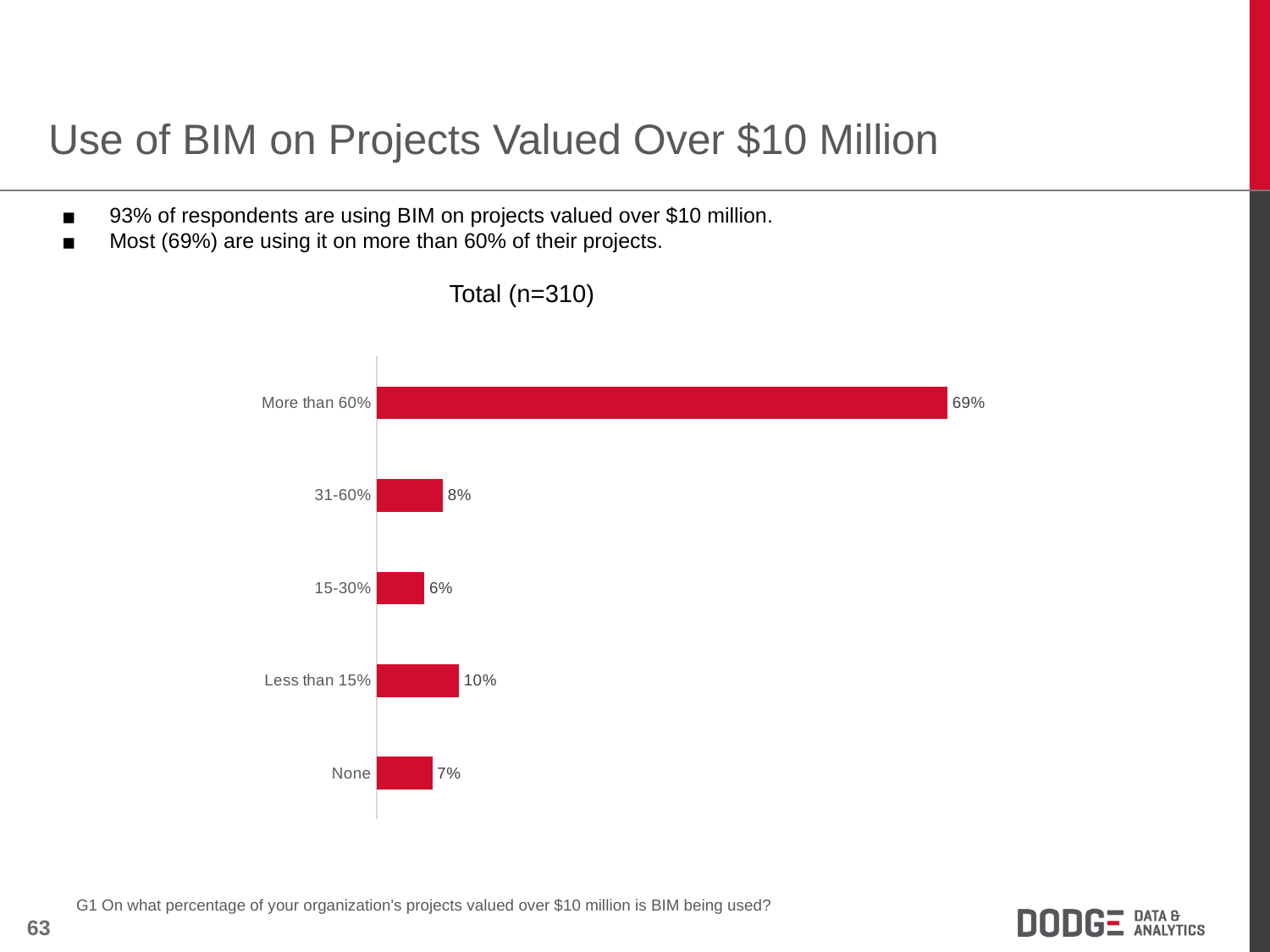
What is the title shown above the chart? Total (n=310) What kind of chart is shown on the slide? Bar chart Which is larger, the value for 'Less than 15%' or the value for 'None'? Less than 15% What percentage of respondents use BIM on more than 60% of their projects valued over $10 million? 69% Which category has the lowest value? 15-30% What is the value for the 'Less than 15%' category? 10% What is the value for the 'None' category? 7% What is the value for the '15-30%' category? 6% What colour are the bars in the chart? Red What is the difference between the 'More than 60%' value and the '31-60%' value? 61% Which category has the highest value? More than 60% How many categories are shown in the chart? 5